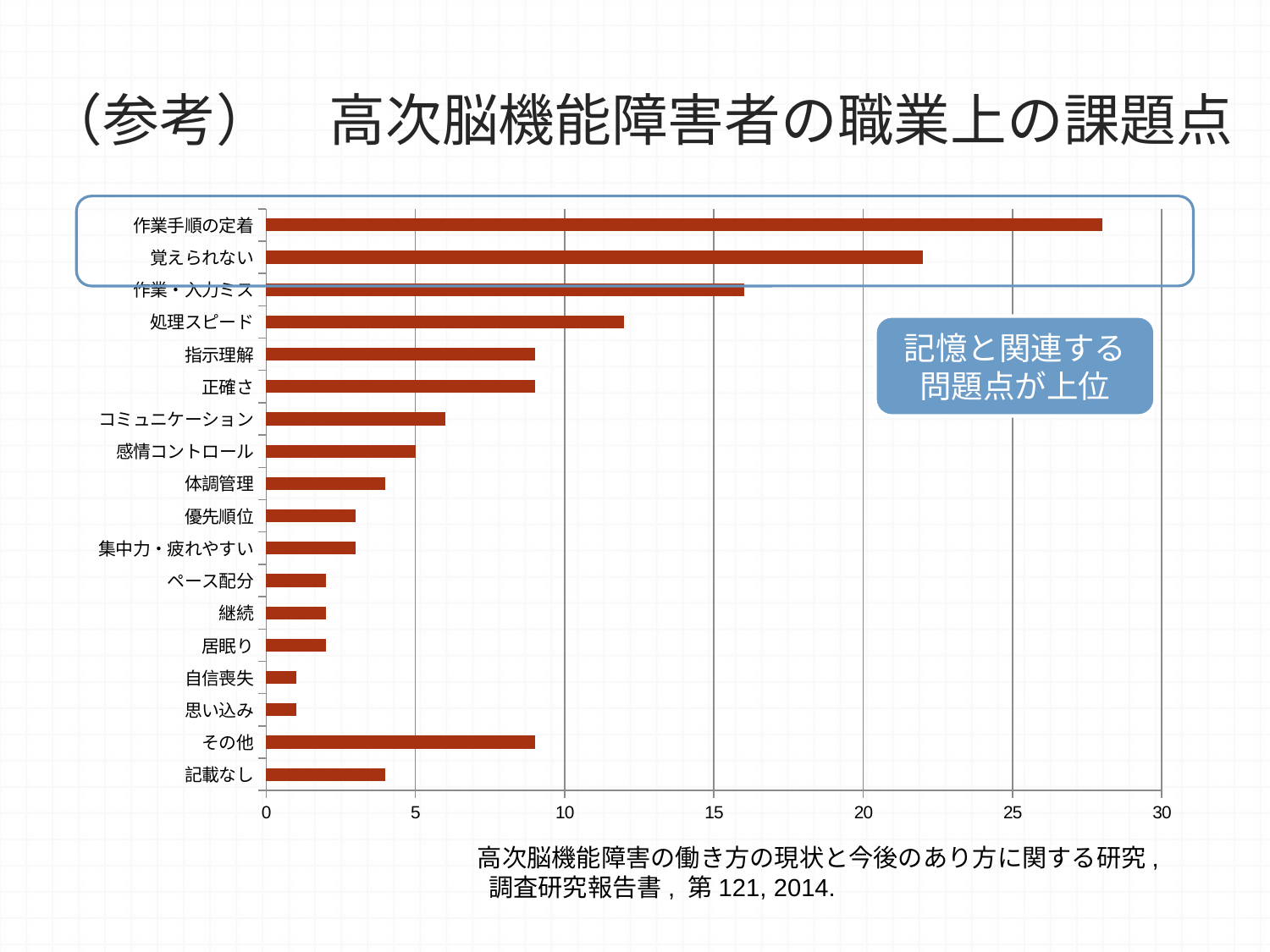
Is the value for 体調管理 greater or less than 5? less Is the value for 処理スピード greater or less than 10? greater Which category has the highest value in the chart? 作業手順の定着 Which is larger, the value for 覚えられない or the value for 作業・入力ミス? 覚えられない What kind of chart is shown on the slide? bar chart Which is larger, the value for その他 or the value for 記載なし? その他 Is the value for コミュニケーション greater or less than 5? greater What is the highest tick value shown on the horizontal axis? 30 How many categories are plotted in the chart? 18